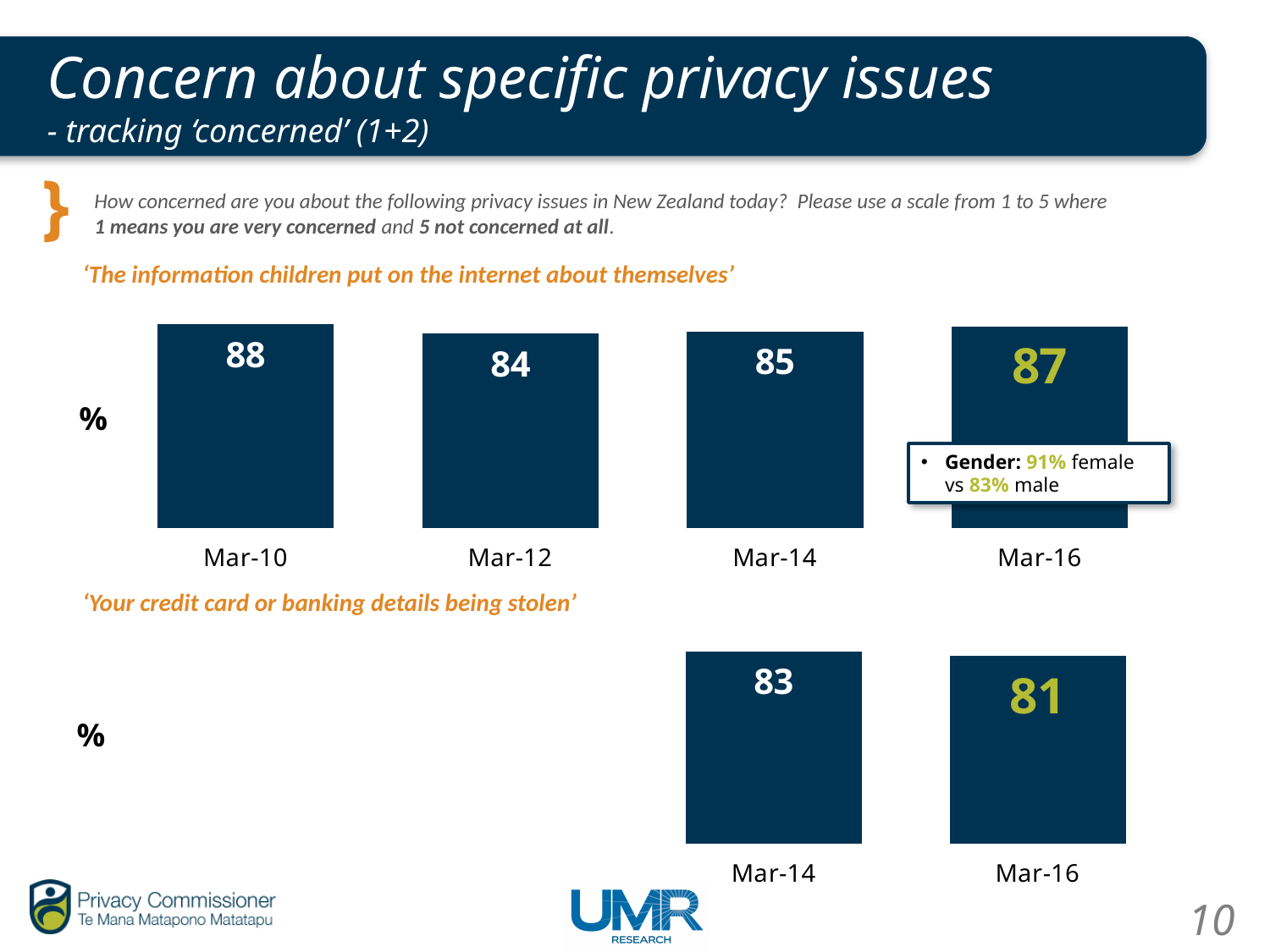
In the chart 'Your credit card or banking details being stolen', what is the value for Mar-16? 81 In the chart 'The information children put on the internet about themselves', which period has the highest value? Mar-10 What kind of chart is used for 'Your credit card or banking details being stolen'? bar chart In the chart 'Your credit card or banking details being stolen', is the value for Mar-14 or Mar-16 larger? Mar-14 In the chart 'The information children put on the internet about themselves', what is the difference between the Mar-10 and Mar-12 values? 4 In the chart 'The information children put on the internet about themselves', what is the value for Mar-12? 84 In the chart 'Your credit card or banking details being stolen', what is the value for Mar-14? 83 In the chart 'Your credit card or banking details being stolen', do the values rise or fall from Mar-14 to Mar-16? fall In the chart 'The information children put on the internet about themselves', which period has the lowest value? Mar-12 In the chart 'The information children put on the internet about themselves', what is the value for Mar-16? 87 In the chart 'The information children put on the internet about themselves', what is the value for Mar-10? 88 In the chart 'The information children put on the internet about themselves', how many periods are shown? 4